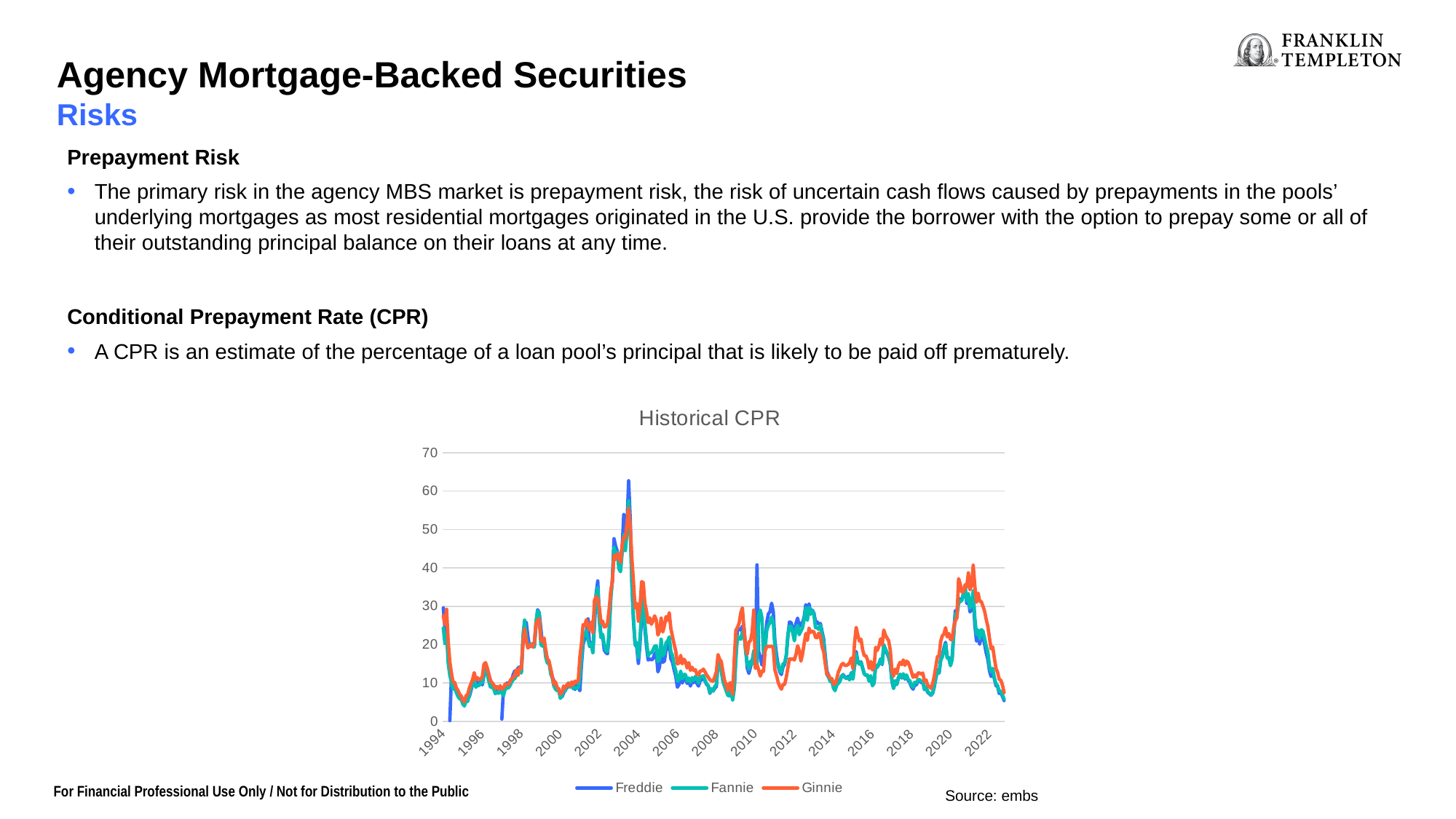
Which series in the Historical CPR chart is drawn in orange? Ginnie In the Historical CPR chart, do the values rise or fall between 2004 and 2006? fall Is the value for Fannie at the end of the series (2022) in the Historical CPR chart greater or less than 10? less What kind of chart is the Historical CPR chart? line chart Which series reaches the highest peak in the Historical CPR chart? Freddie Is the peak value for Ginnie around 2021 in the Historical CPR chart greater or less than 30? greater How many series does the legend of the Historical CPR chart list? 3 Between which two labelled years does the highest peak of the Historical CPR chart occur? 2002 and 2004 Is the highest value for Freddie in the Historical CPR chart greater or less than 50? greater What is the title of the chart on the slide? Historical CPR What is the highest value shown on the y axis of the Historical CPR chart? 70 How many year labels are shown on the x axis of the Historical CPR chart? 15